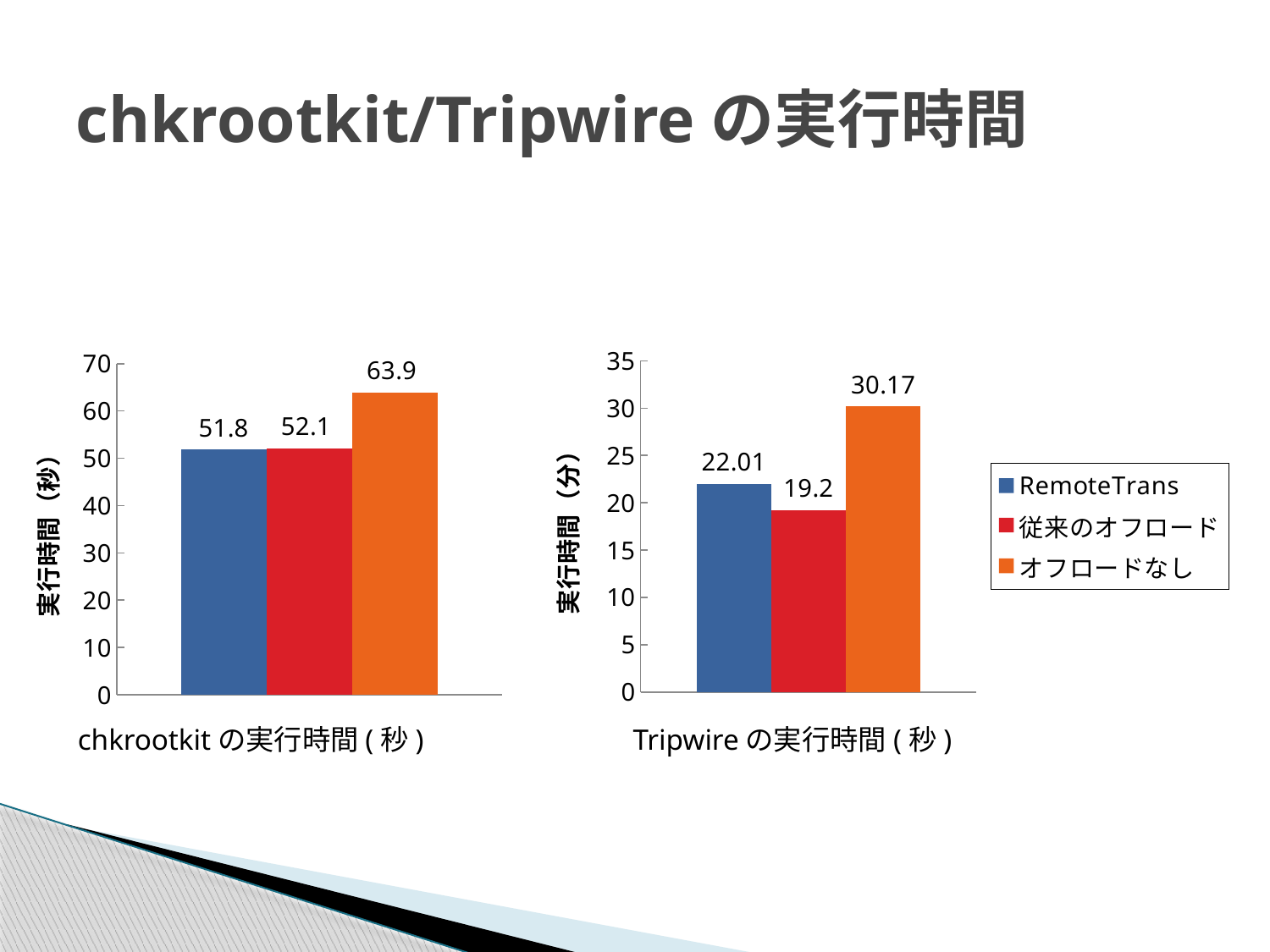
In the Tripwire chart on the right, what is the execution time for 従来のオフロード? 19.2 How many series does the legend list? 3 In the chkrootkit chart on the left, what is the difference between the オフロードなし value and the 従来のオフロード value? 11.8 In the Tripwire chart on the right, which is larger: the value for RemoteTrans or the value for オフロードなし? オフロードなし In the Tripwire chart on the right, which series has the lowest execution time? 従来のオフロード In the chkrootkit chart on the left, which series has the highest execution time? オフロードなし In the chkrootkit chart on the left, is the value for オフロードなし greater or less than 60? greater In the Tripwire chart on the right, what is the execution time for RemoteTrans? 22.01 In the chkrootkit chart on the left, what is the execution time for RemoteTrans? 51.8 In the Tripwire chart on the right, what is the difference between the オフロードなし value and the RemoteTrans value? 8.16 What kind of chart is the Tripwire chart on the right? bar chart In the chkrootkit chart on the left, what is the execution time for オフロードなし? 63.9